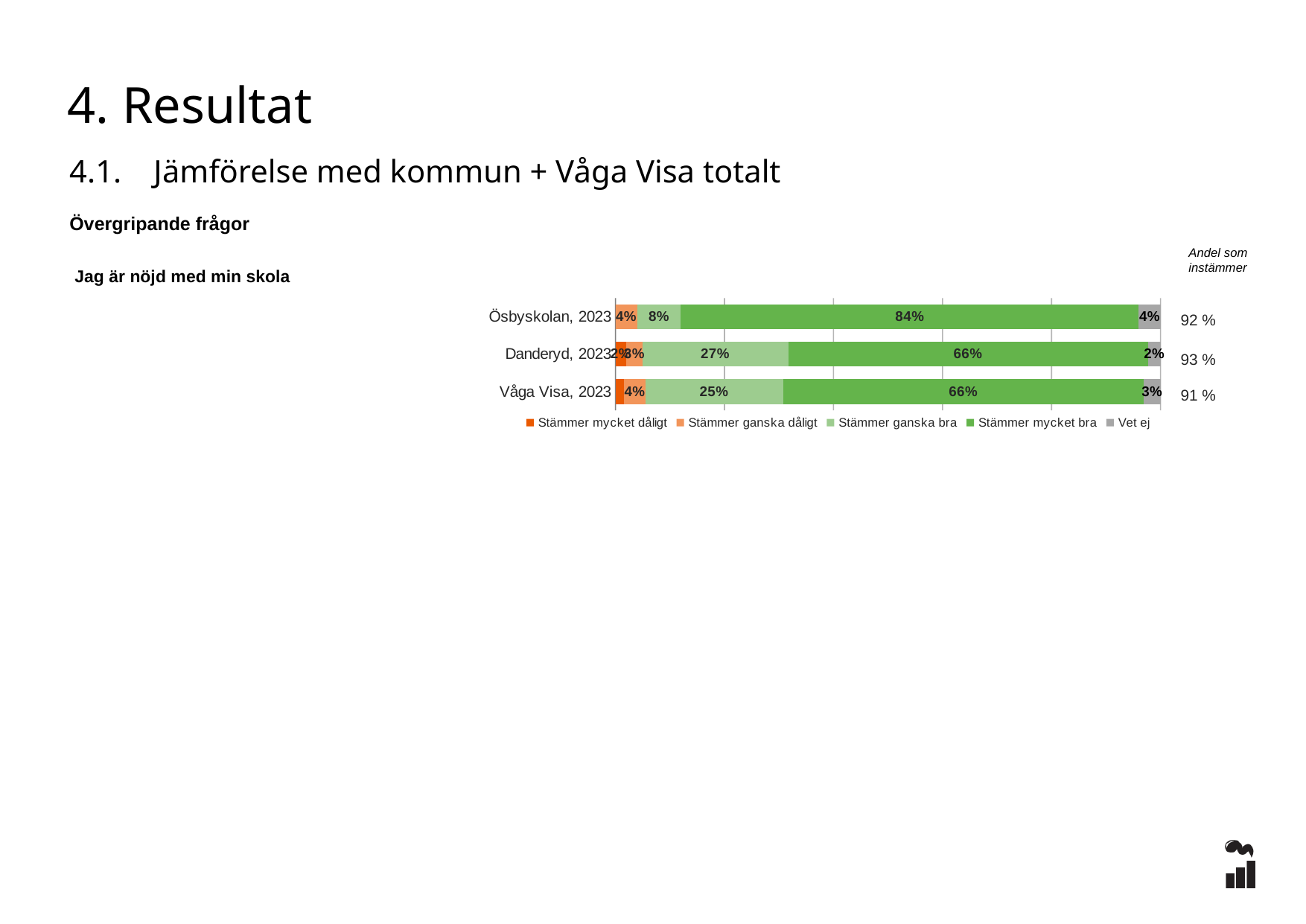
What is the value for "Stämmer mycket bra" for Våga Visa, 2023? 66% What is the "Vet ej" value for Ösbyskolan, 2023? 4% Which category has the lowest "Andel som instämmer" value? Våga Visa, 2023 What is the difference in "Stämmer mycket bra" between Ösbyskolan, 2023 and Danderyd, 2023? 18 percentage points What is the value for "Stämmer ganska bra" for Danderyd, 2023? 27% Which category has the highest value for "Stämmer mycket bra"? Ösbyskolan, 2023 Which has the larger "Stämmer ganska bra" value, Danderyd, 2023 or Våga Visa, 2023? Danderyd, 2023 How many series does the legend list? 5 How many categories (bars) are shown in the chart? 3 What is the value for "Stämmer mycket bra" for Ösbyskolan, 2023? 84% What is the "Andel som instämmer" value shown for Danderyd, 2023? 93 % What kind of chart is shown on the slide? Stacked bar chart